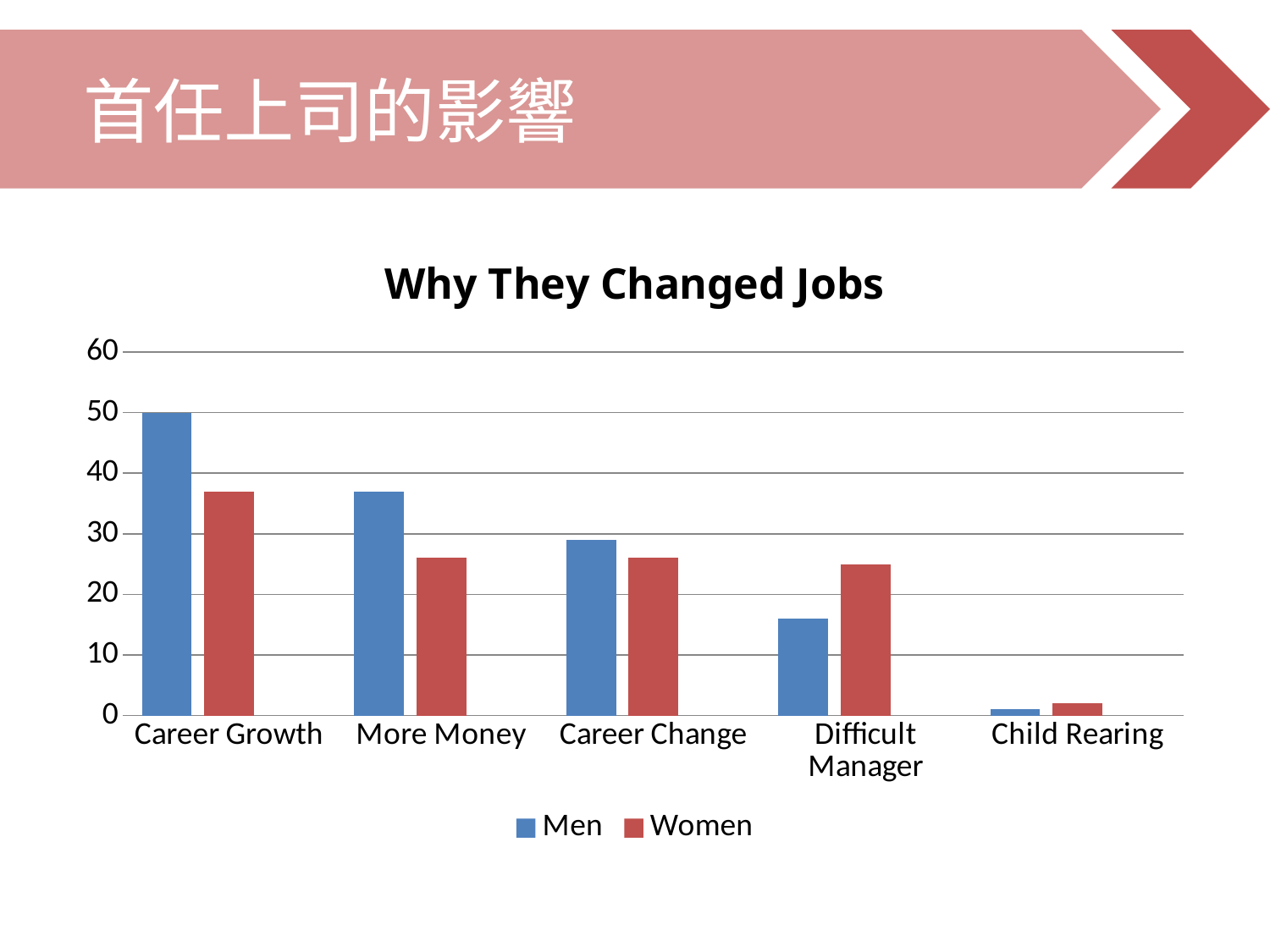
In the Difficult Manager category, which is larger, Men or Women? Women How many series does the legend list? 2 Which category has the highest value for Men? Career Growth In the Career Growth category, which is larger, Men or Women? Men How many categories are shown on the x axis? 5 Which category has the lowest value for Women? Child Rearing What is the title of the chart? Why They Changed Jobs Is the value for Men in More Money greater or less than 30? greater Do the values for Men rise or fall from Career Growth to Child Rearing along the x axis? fall What is the value for Men in the Career Growth category? 50 Is the value for Women in More Money greater or less than 30? less What kind of chart is shown on the slide? bar chart